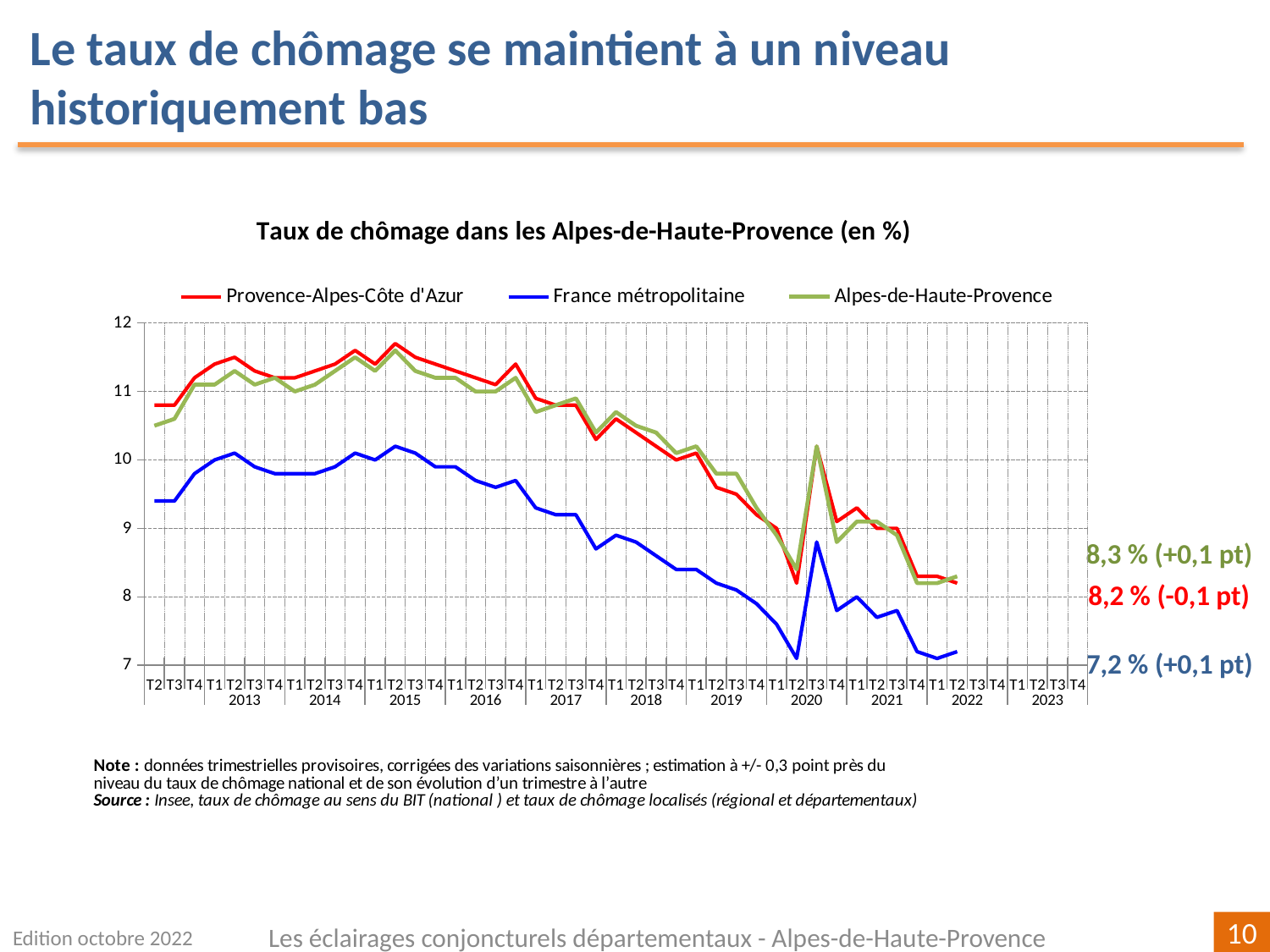
What is the latest unemployment rate shown for Provence-Alpes-Côte d'Azur? 8,2 % What kind of chart is shown on the slide? Line chart What quarterly change is annotated for Provence-Alpes-Côte d'Azur at the latest point? -0,1 pt Which series has the lowest value at the latest point? France métropolitaine Is the value for France métropolitaine in T2 2020 greater or less than 8? less What is the title of the chart? Taux de chômage dans les Alpes-de-Haute-Provence (en %) What is the latest unemployment rate shown for France métropolitaine? 7,2 % Overall, does the France métropolitaine line rise or fall between 2013 and 2022? fall What is the latest unemployment rate shown for Alpes-de-Haute-Provence? 8,3 % At the latest point, which is higher: Alpes-de-Haute-Provence or France métropolitaine? Alpes-de-Haute-Provence At the latest point, what is the difference between the Alpes-de-Haute-Provence rate and the France métropolitaine rate? 1,1 points How many series does the legend list? 3